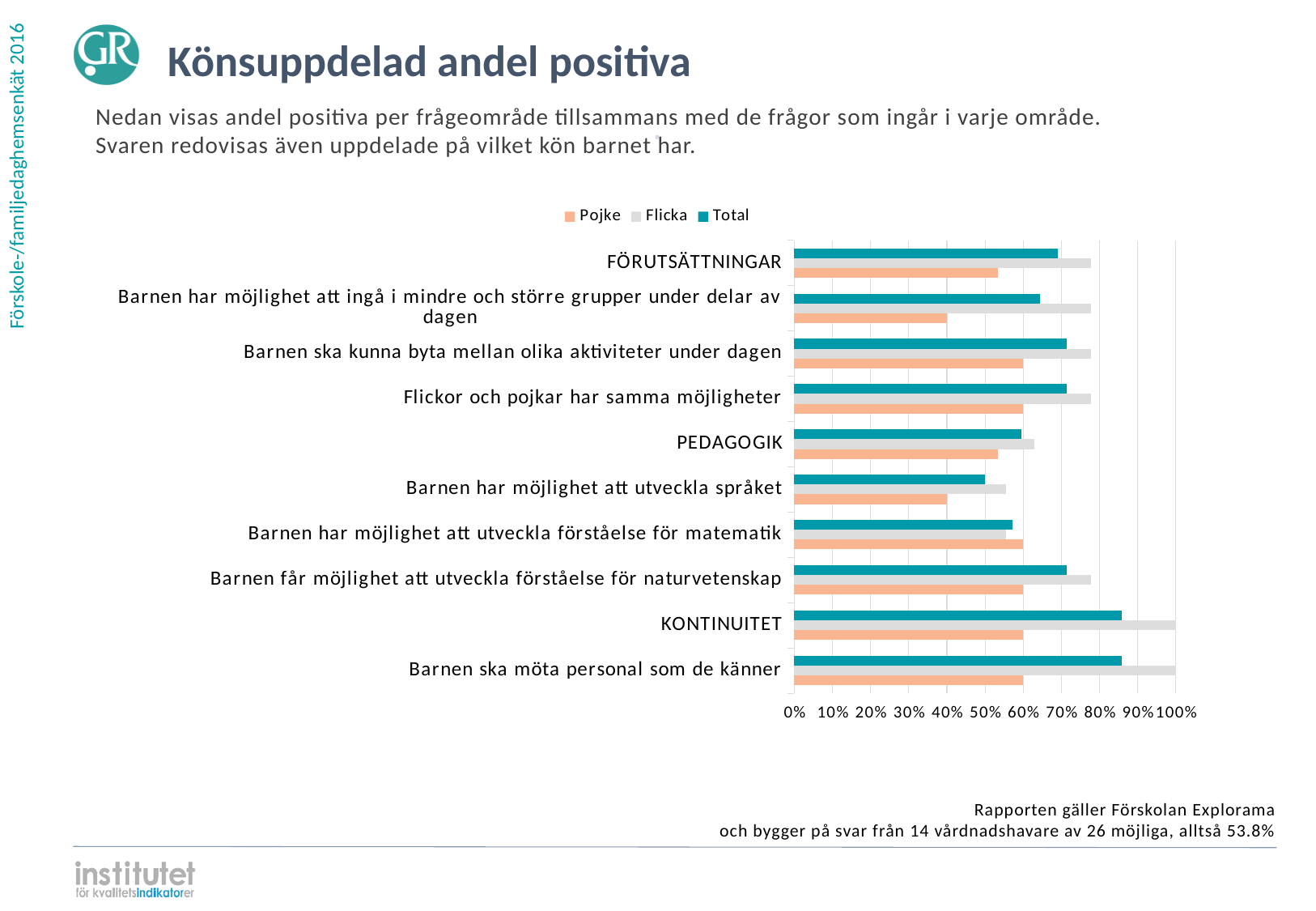
Which category has the lowest Total value? Barnen har möjlighet att utveckla språket Is the Total value for PEDAGOGIK greater or less than 70%? less For KONTINUITET, which series has the highest value? Flicka Is the Flicka value for FÖRUTSÄTTNINGAR greater or less than 70%? greater For 'Barnen har möjlighet att ingå i mindre och större grupper under delar av dagen', which is larger: the Flicka value or the Pojke value? Flicka Is the Pojke value for 'Barnen har möjlighet att utveckla språket' greater or less than 50%? less How many series does the legend list? 3 What kind of chart is shown on the slide? bar chart How many categories are plotted on the y axis of the chart? 10 Which series are listed in the chart legend? Pojke, Flicka, Total